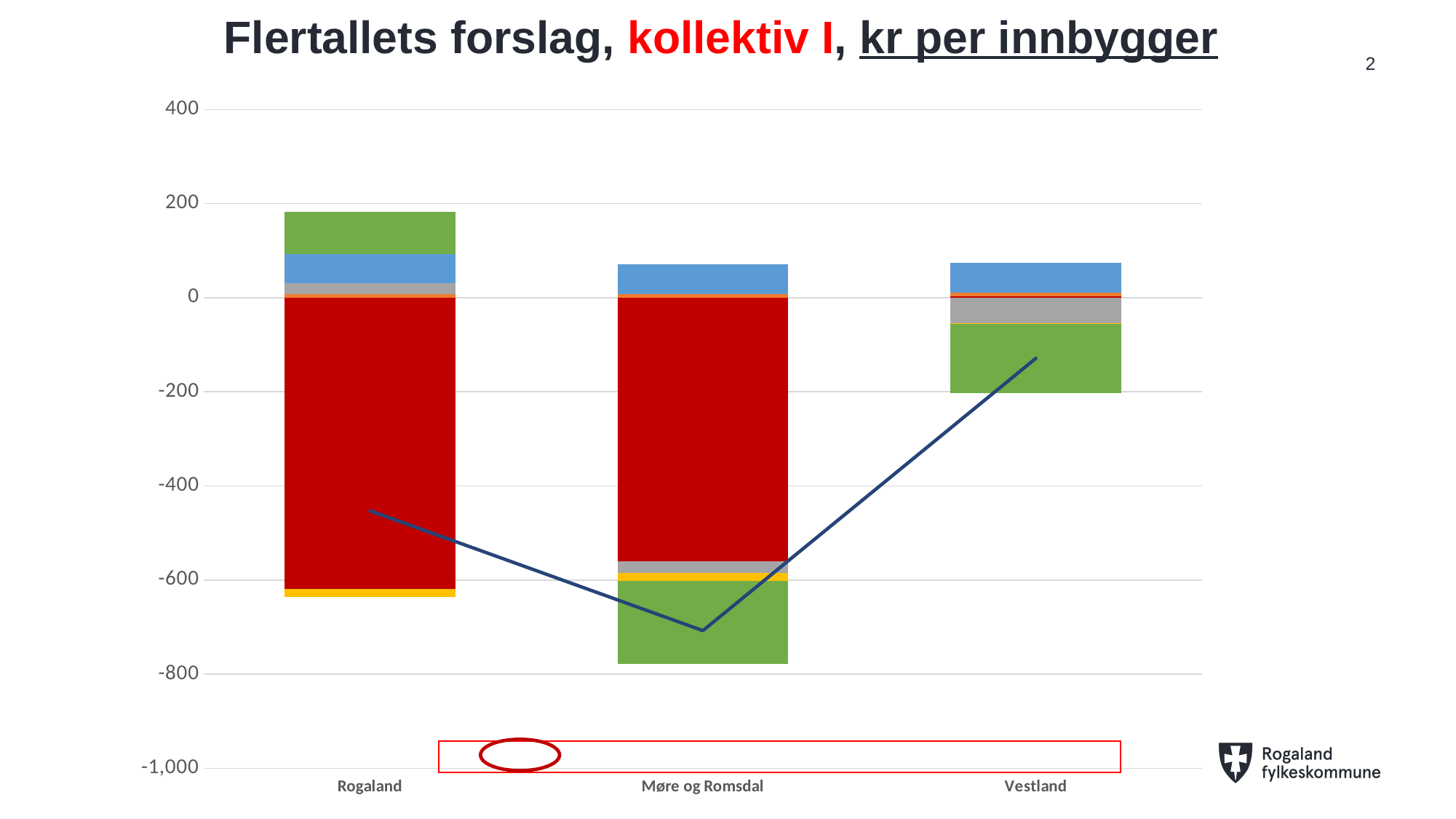
Which category has the stacked bar that reaches highest above zero? Rogaland At which category does the line series reach its lowest point? Møre og Romsdal How many categories are shown on the x axis? 3 What are the three categories on the x axis? Rogaland, Møre og Romsdal, Vestland Which category has the stacked bar that extends lowest below zero? Møre og Romsdal Is the line value for Rogaland greater or less than -600? greater At which category does the line series reach its highest point? Vestland What kind of chart is shown on the slide? Stacked bar chart with a line Is the line value for Møre og Romsdal greater or less than -600? less Is the bottom of the stacked bar for Vestland greater or less than -400? greater What is the title of the chart? Flertallets forslag, kollektiv I, kr per innbygger